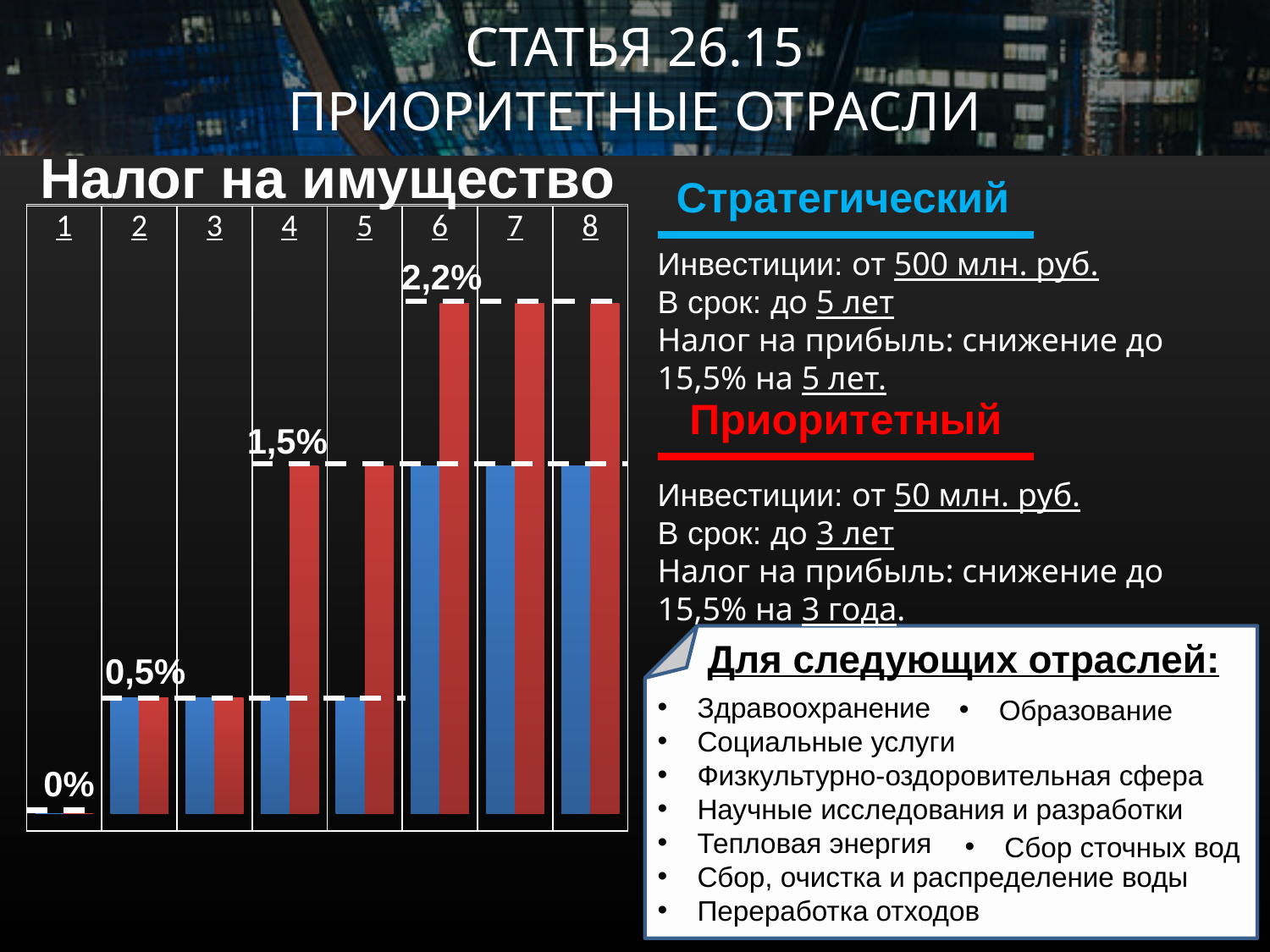
What kind of chart is shown under the heading 'Налог на имущество'? bar chart What is the value of the red bar for year 6 in the 'Налог на имущество' chart? 2,2% What is the value shown for year 1 in the 'Налог на имущество' chart? 0% In the 'Налог на имущество' chart, which bar is higher for year 4, the blue one or the red one? the red one How many categories (years) are shown on the x axis of the 'Налог на имущество' chart? 8 What is the title of the chart on the left of the slide? Налог на имущество What is the value of the red bar for year 4 in the 'Налог на имущество' chart? 1,5% What is the value of the blue bar for year 2 in the 'Налог на имущество' chart? 0,5% In the 'Налог на имущество' chart, what is the difference between the red bar and the blue bar for year 7? 0,7% Do the red bars in the 'Налог на имущество' chart rise or fall from year 2 to year 8? rise What is the value of the blue bar for year 6 in the 'Налог на имущество' chart? 1,5% In the 'Налог на имущество' chart, is the red bar for year 5 greater or less than 0,5%? greater